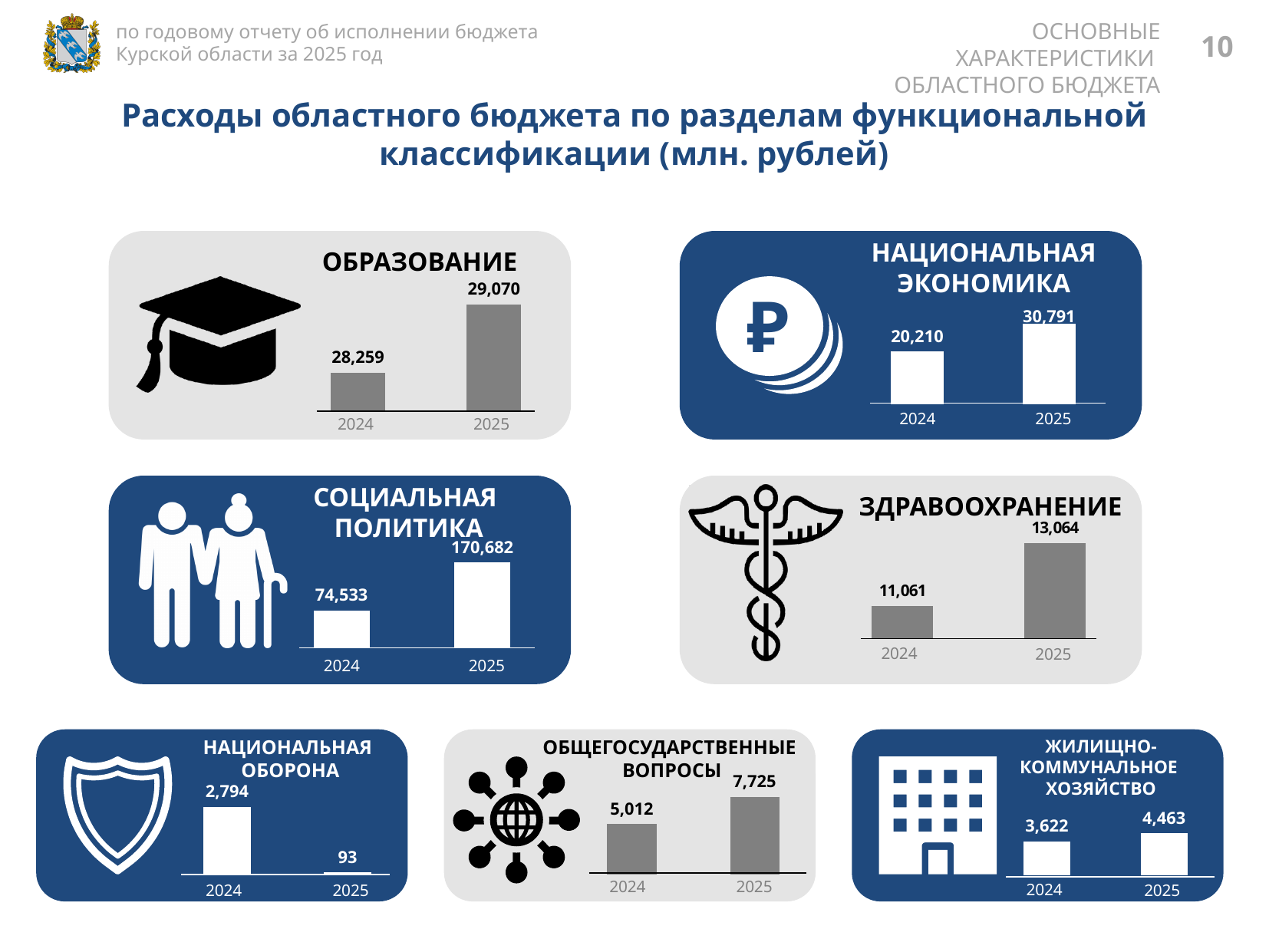
In the 'НАЦИОНАЛЬНАЯ ЭКОНОМИКА' chart, what is the value for 2024? 20,210 In the 'НАЦИОНАЛЬНАЯ ОБОРОНА' chart, do the values rise or fall from 2024 to 2025? fall In the 'СОЦИАЛЬНАЯ ПОЛИТИКА' chart, is the 2025 value larger or smaller than the 2024 value? larger How many bars does the 'ЗДРАВООХРАНЕНИЕ' chart show? 2 In the 'ЗДРАВООХРАНЕНИЕ' chart, what is the difference between the 2025 and 2024 values? 2,003 In the 'НАЦИОНАЛЬНАЯ ОБОРОНА' chart, which year has the lower value? 2025 In the 'ЖИЛИЩНО-КОММУНАЛЬНОЕ ХОЗЯЙСТВО' chart, what is the value for 2024? 3,622 In the 'НАЦИОНАЛЬНАЯ ЭКОНОМИКА' chart, what is the difference between the 2025 and 2024 values? 10,581 What type of chart is used in the 'ОБРАЗОВАНИЕ' panel? bar chart In the 'ОБРАЗОВАНИЕ' chart, what is the value for 2025? 29,070 In the 'ОБЩЕГОСУДАРСТВЕННЫЕ ВОПРОСЫ' chart, which year has the higher value? 2025 In the 'СОЦИАЛЬНАЯ ПОЛИТИКА' chart, what is the value for 2025? 170,682